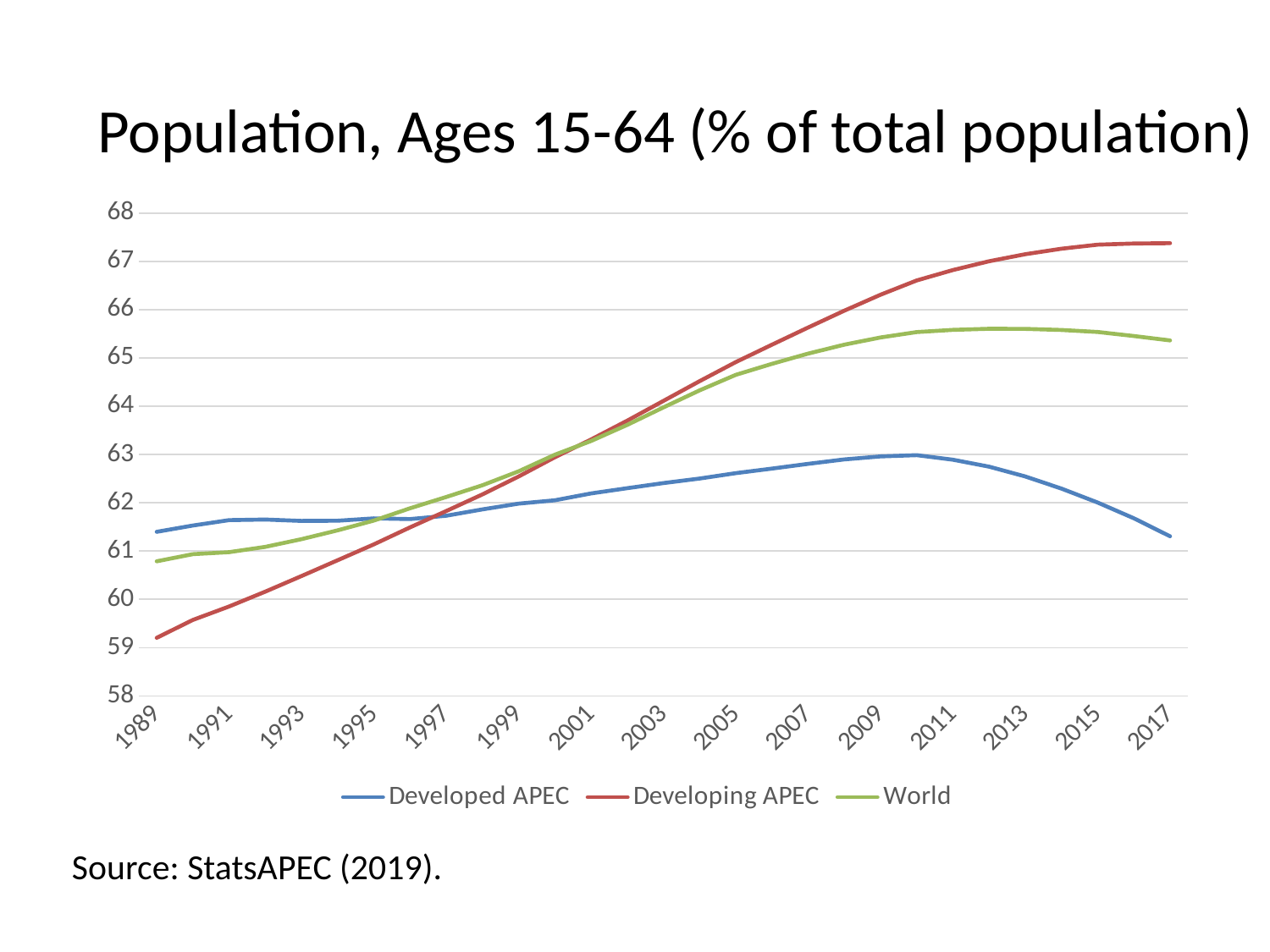
What kind of chart is shown on the slide? Line chart How many series does the legend list? 3 Which series is shown in red? Developing APEC Is the value for Developing APEC in 1989 greater or less than 60? less Is the value for World in 2017 greater or less than 65? greater Which series has the highest value in 2017? Developing APEC In 2017, which is larger: the value for Developed APEC or the value for World? World Which series has the lowest value in 1989? Developing APEC Is the value for Developing APEC in 2017 greater or less than 67? greater What is the title of the chart? Population, Ages 15-64 (% of total population) Does the Developing APEC line rise or fall from 1989 to 2017? Rise